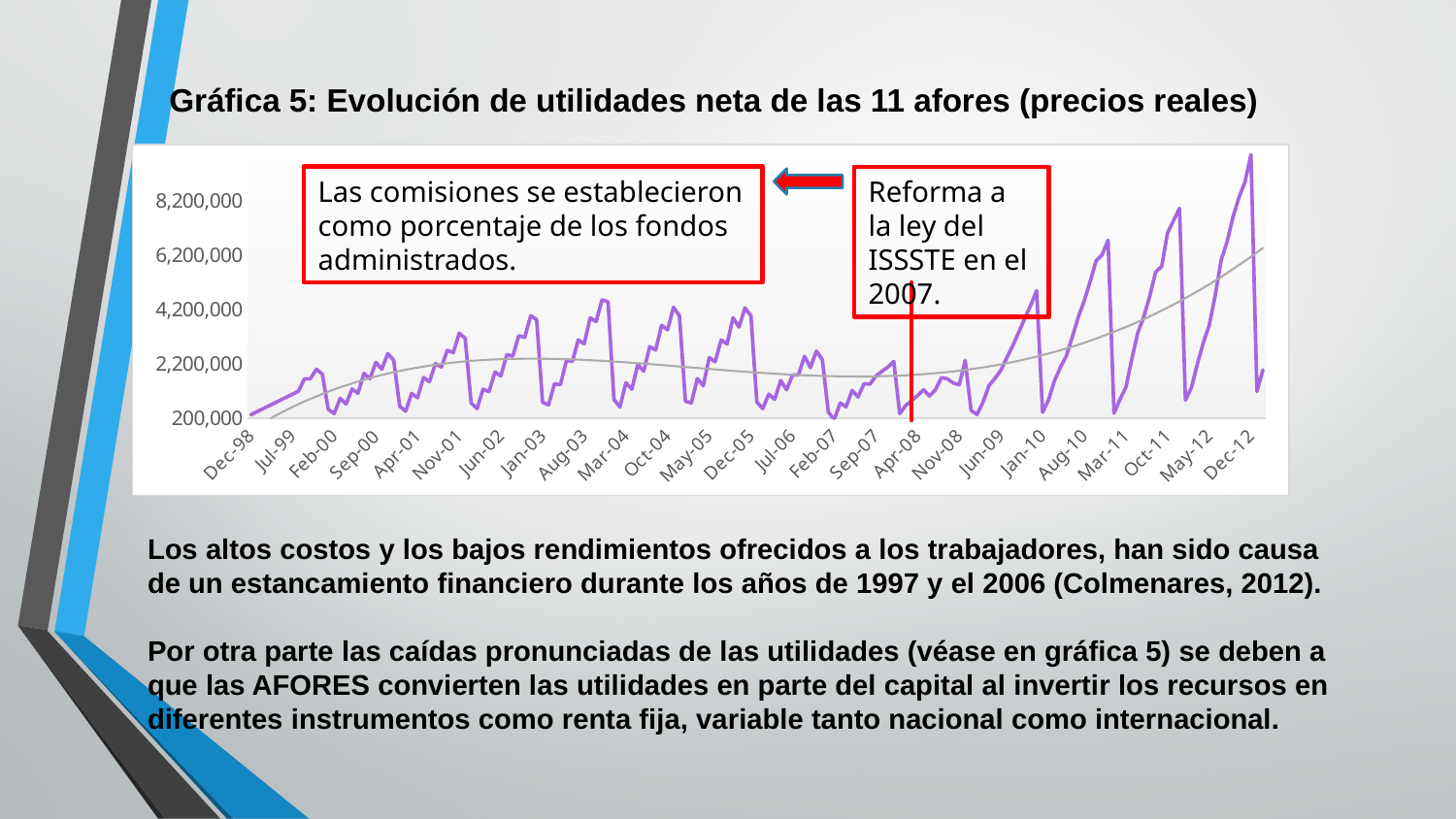
Is the value of the purple line at Dec-12 greater or less than 2,200,000? greater Is the value of the purple line at Apr-08 greater or less than 2,200,000? less Does the gray trend line rise or fall between Jan-03 and Feb-07? falls Is the peak of the purple line around Oct-11 greater or less than 6,200,000? greater What is the title of the chart on the slide? Gráfica 5: Evolución de utilidades neta de las 11 afores (precios reales) How many date labels are shown along the x axis of the chart? 25 Which is larger: the peak of the purple line around Oct-11 or the peak around Aug-03? the peak around Oct-11 In which year does the purple line reach its highest peak? 2012 What is the highest value shown on the vertical axis of the chart? 8,200,000 Does the gray trend line rise or fall between Nov-08 and Dec-12? rises What kind of chart is shown on the slide? line chart